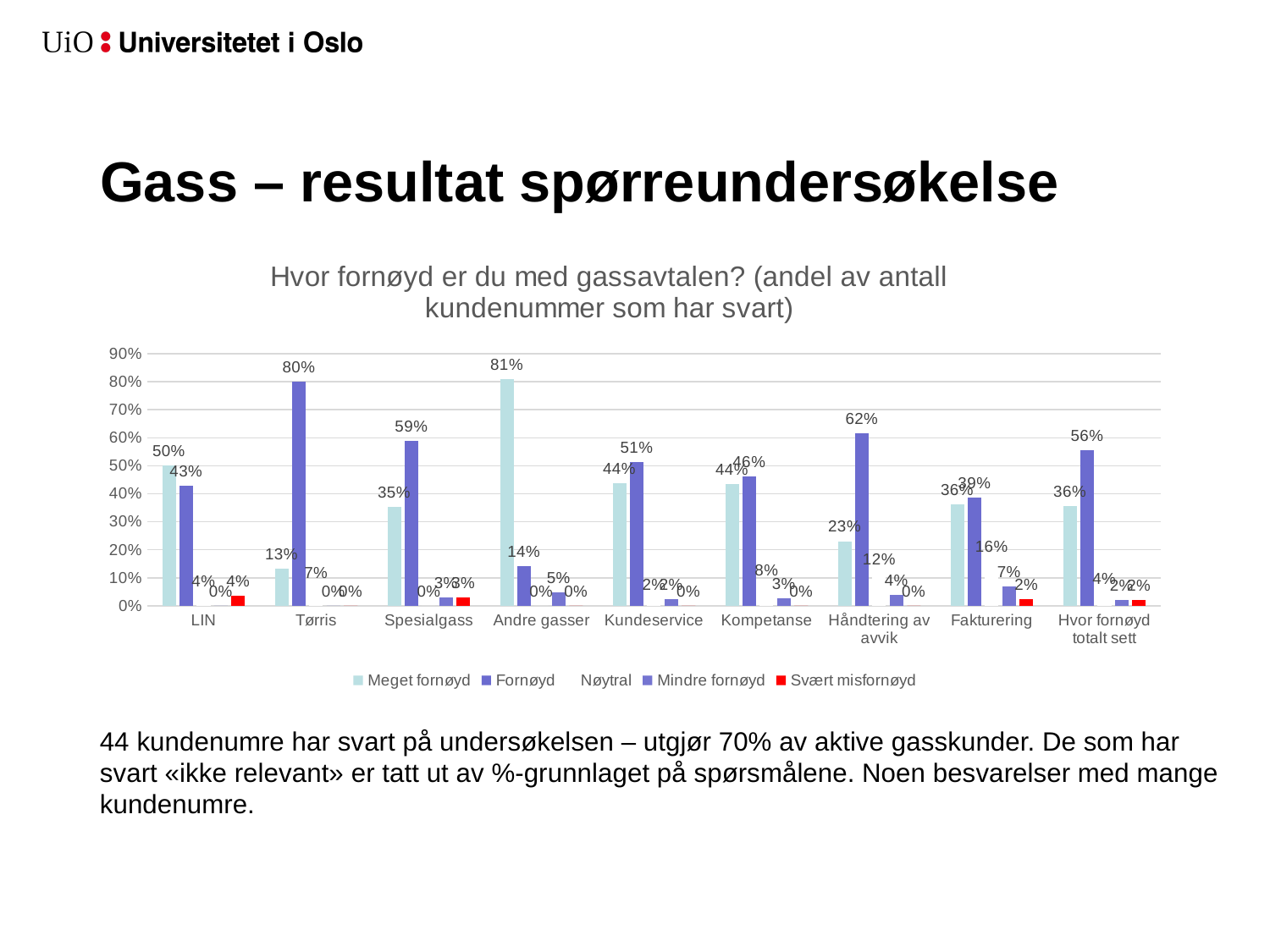
Which category has the highest value in the Meget fornøyd series? Andre gasser What is the value of the Fornøyd series for Tørris? 80% How many series does the legend list? 5 For LIN, which is larger: the Meget fornøyd value or the Fornøyd value? Meget fornøyd Which category has the lowest value in the Meget fornøyd series? Tørris Which category has the highest value in the Fornøyd series? Tørris What is the value of the Fornøyd series for Hvor fornøyd totalt sett? 56% For Håndtering av avvik, what is the difference between the Fornøyd value and the Meget fornøyd value? 39 percentage points What is the title of the chart? Hvor fornøyd er du med gassavtalen? (andel av antall kundenummer som har svart) How many categories are shown on the x axis of the chart? 9 What is the value of the Meget fornøyd series for Andre gasser? 81% What kind of chart is shown on the slide? Bar chart